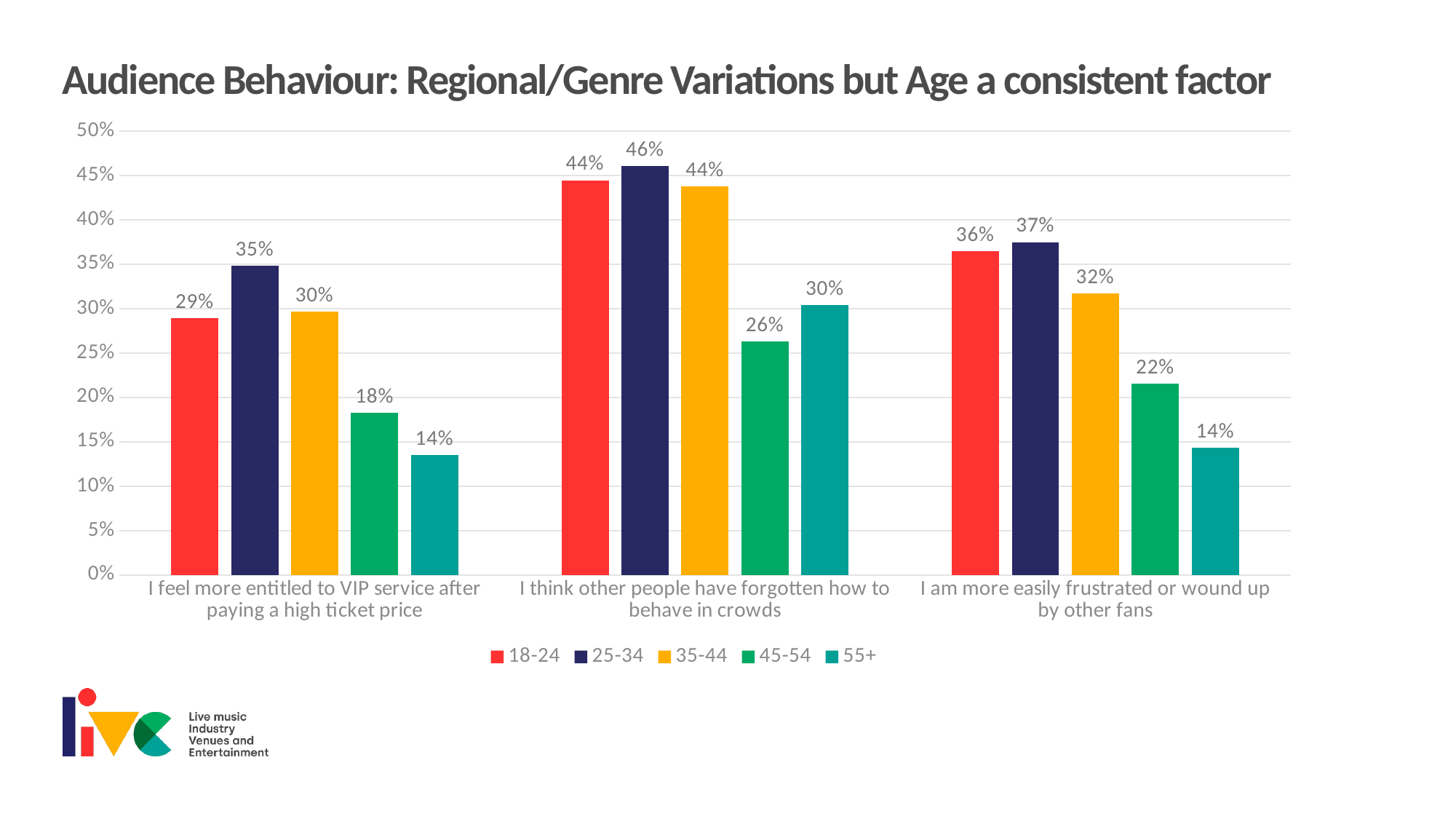
Is the 18-24 value for 'I think other people have forgotten how to behave in crowds' greater or less than 40%? greater How many age groups does the legend list? 5 What is the difference between the 18-24 and 55+ values for 'I am more easily frustrated or wound up by other fans'? 22 percentage points What percentage of 45-54 year olds say they are more easily frustrated or wound up by other fans? 22% What type of chart is shown on the slide? Bar chart What is the title of the chart? Audience Behaviour: Regional/Genre Variations but Age a consistent factor How many statements (categories) are shown on the x axis? 3 Which age group has the highest value for 'I think other people have forgotten how to behave in crowds'? 25-34 Which age group has the lowest value for 'I feel more entitled to VIP service after paying a high ticket price'? 55+ What is the value for the 55+ group for 'I think other people have forgotten how to behave in crowds'? 30% For 'I feel more entitled to VIP service after paying a high ticket price', which is larger: the 35-44 value or the 45-54 value? 35-44 What percentage of 25-34 year olds feel more entitled to VIP service after paying a high ticket price? 35%